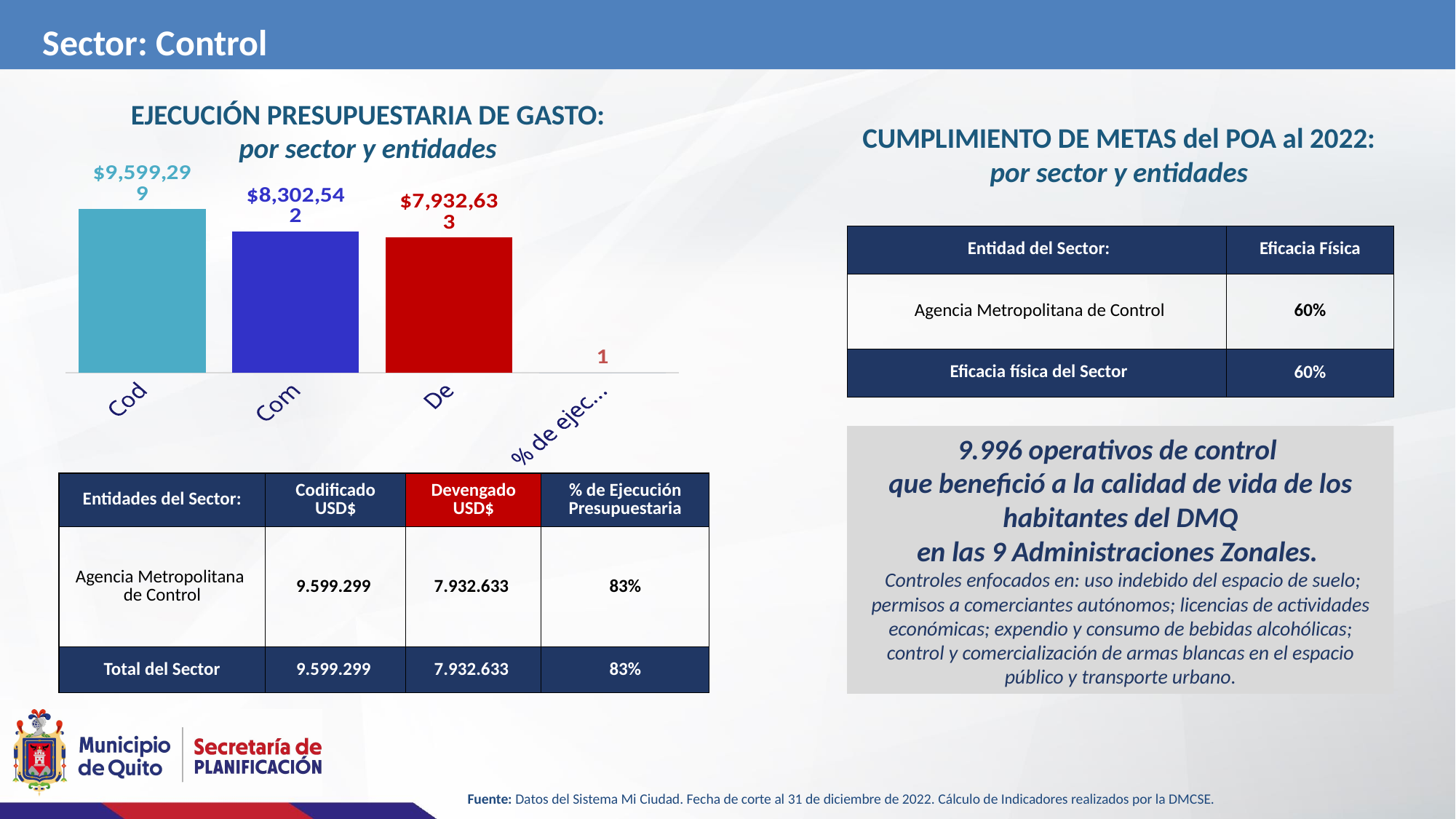
Which category has the highest value in the chart? Cod Do the values in the chart rise or fall from left to right along the x axis? Fall What value is shown for the "% de ejec..." category in the chart? 1 What is the value of the "Cod" bar in the chart? $9,599,299 Which category has the lowest value in the chart? % de ejec... What is the difference between the "Com" and "De" values in the chart? $369,909 How many categories are shown on the x axis of the chart? 4 What type of chart is shown on the slide? Bar chart What is the value of the "De" bar in the chart? $7,932,633 Which is larger in the chart, the "Com" bar or the "De" bar? Com What is the value of the "Com" bar in the chart? $8,302,542 What is the difference between the "Cod" and "De" values in the chart? $1,666,666